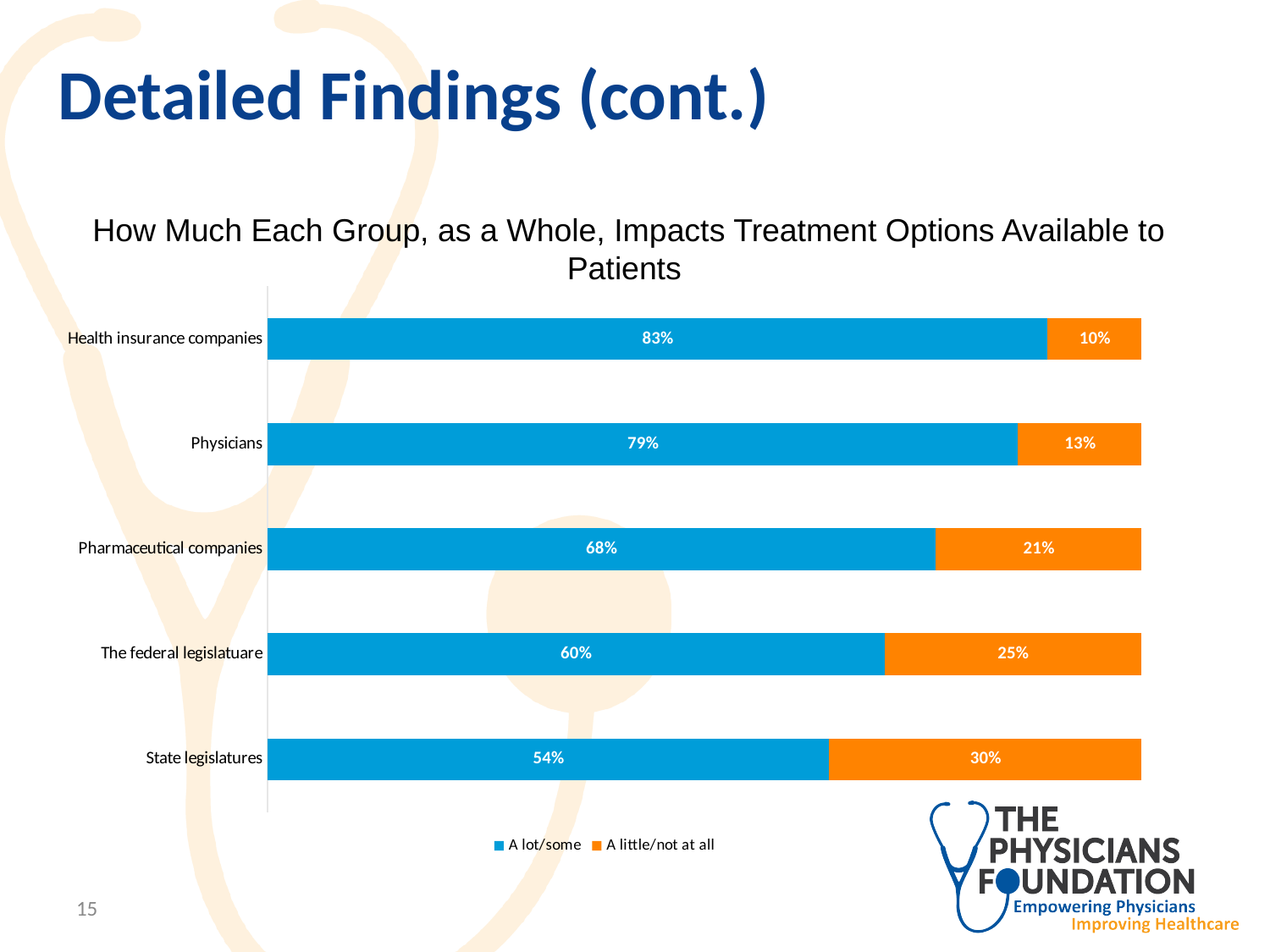
Which group has the lowest "A lot/some" percentage? State legislatures What percentage of respondents said health insurance companies impact treatment options "A lot/some"? 83% Which colour represents "A little/not at all" in the chart? Orange What is the "A lot/some" value for Pharmaceutical companies? 68% What kind of chart is shown on the slide? Stacked bar chart How many groups are shown on the chart? 5 Which is larger: the "A little/not at all" value for Pharmaceutical companies or for Physicians? Pharmaceutical companies What is the "A little/not at all" value for State legislatures? 30% How many series does the legend list? 2 What is the difference between the "A lot/some" values for Physicians and The federal legislatuare? 19% Which group has the highest "A lot/some" percentage? Health insurance companies What is the combined total of the two labelled segments for The federal legislatuare? 85%